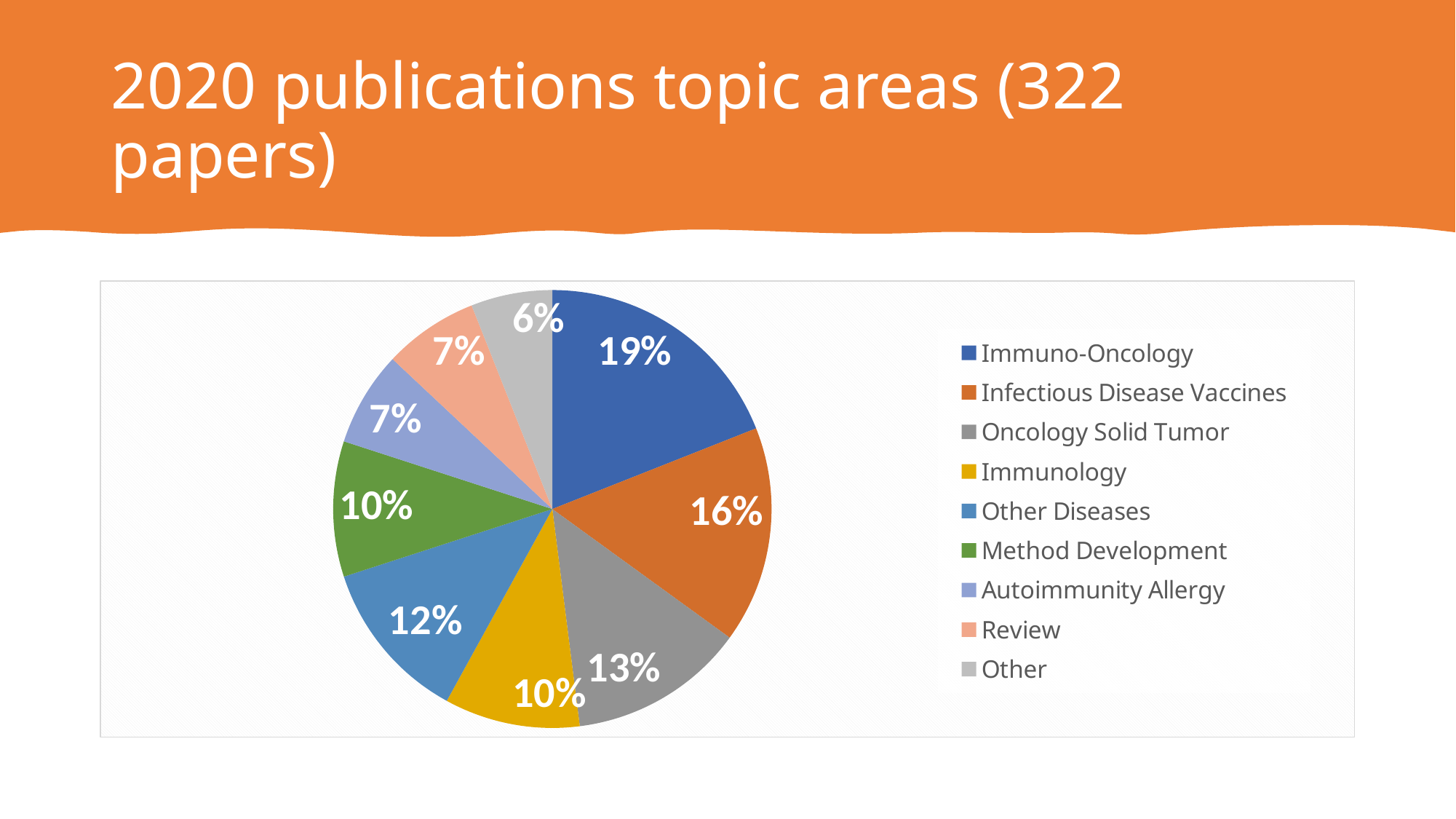
What share of the pie does Infectious Disease Vaccines represent? 16% What kind of chart is shown on the slide? Pie chart What share of the pie does Immuno-Oncology represent? 19% How many topic areas are shown in the pie chart? 9 What is the difference in percentage points between Immuno-Oncology and Infectious Disease Vaccines? 3 Which is larger, the share for Other Diseases or the share for Method Development? Other Diseases Which topic area has the largest slice of the pie? Immuno-Oncology What is the value shown for Review? 7% What is the value shown for Other Diseases? 12% What is the value shown for Oncology Solid Tumor? 13% What is the title of the slide containing the chart? 2020 publications topic areas (322 papers) Which topic area has the smallest slice of the pie? Other